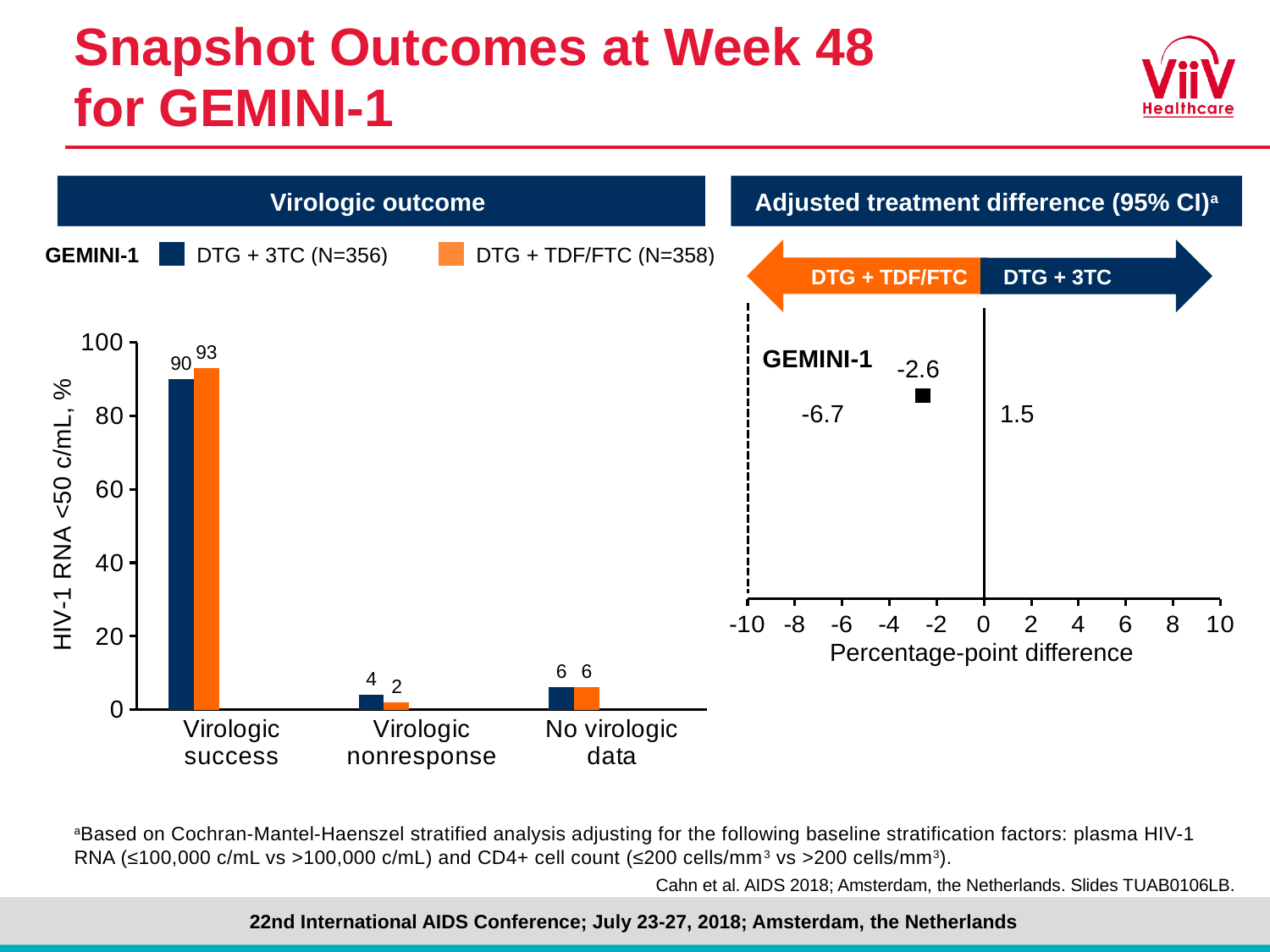
In the Virologic outcome chart, which series has the larger value in the Virologic nonresponse category? DTG + 3TC What kind of chart is the Virologic outcome chart? Bar chart In the Virologic outcome chart, what is the value for DTG + TDF/FTC in the Virologic success category? 93 In the Virologic outcome chart, what is the difference between DTG + TDF/FTC and DTG + 3TC in the Virologic success category? 3 How many series does the legend of the Virologic outcome chart list? 2 In the Virologic outcome chart, which category has the lowest value for DTG + TDF/FTC? Virologic nonresponse In the Virologic outcome chart, which category has the highest value for DTG + 3TC? Virologic success In the Virologic outcome chart, what is the value for DTG + 3TC in the Virologic nonresponse category? 4 In the Virologic outcome chart, what is the value for DTG + TDF/FTC in the No virologic data category? 6 In the Adjusted treatment difference chart, what is the point estimate of the percentage-point difference for GEMINI-1? -2.6 In the Virologic outcome chart, what is the value for DTG + 3TC in the Virologic success category? 90 How many categories are shown on the x axis of the Virologic outcome chart? 3